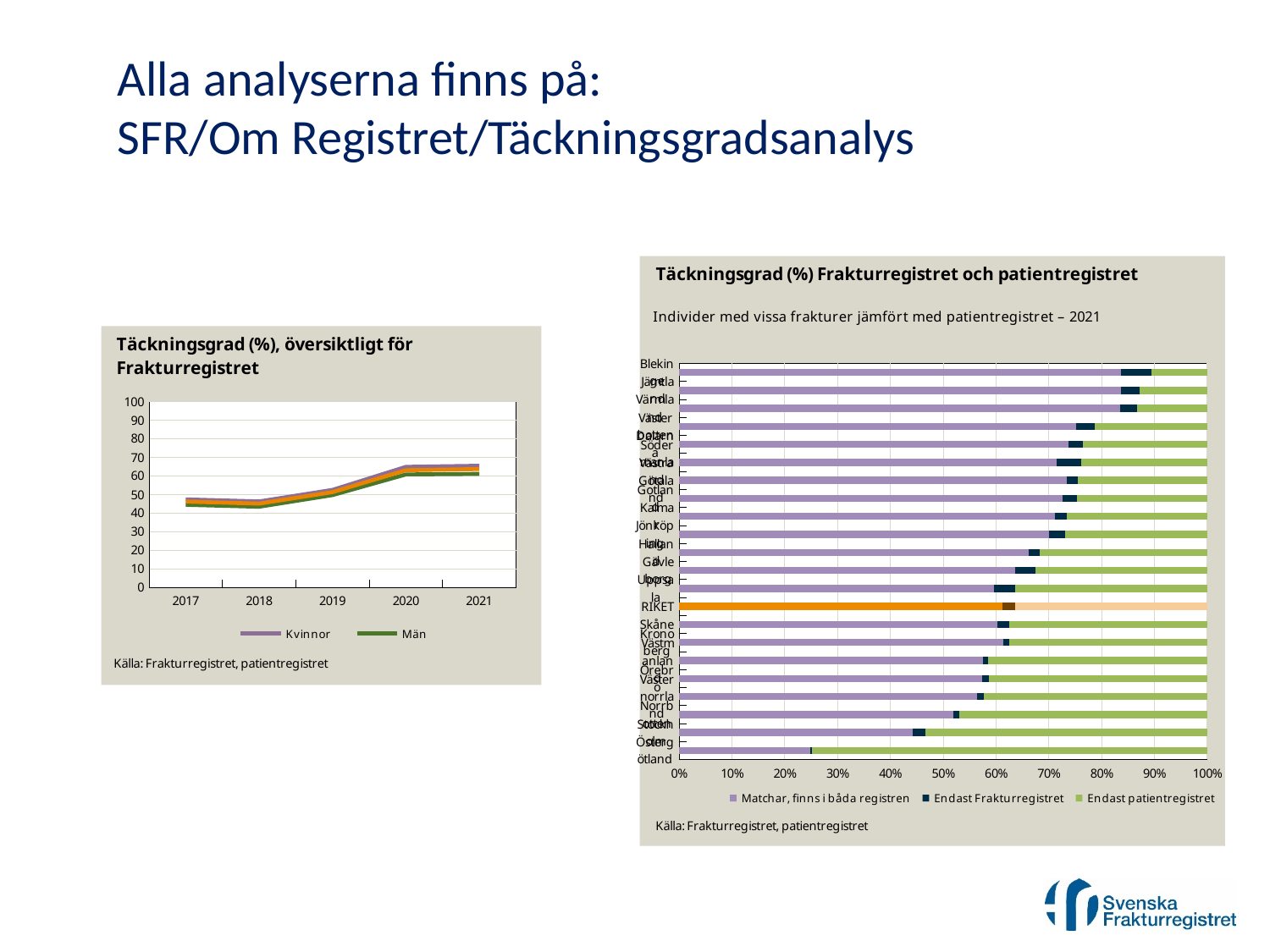
What kind of chart is the left chart titled 'Täckningsgrad (%), översiktligt för Frakturregistret'? Line chart In the left chart 'Täckningsgrad (%), översiktligt för Frakturregistret', is the value for Kvinnor in 2021 greater or less than 50? greater In the right chart 'Täckningsgrad (%) Frakturregistret och patientregistret', is the 'Matchar, finns i båda registren' value for RIKET greater or less than 50%? greater In the left chart 'Täckningsgrad (%), översiktligt för Frakturregistret', is the value for Män in 2018 greater or less than 50? less What kind of chart is the right chart titled 'Täckningsgrad (%) Frakturregistret och patientregistret'? Stacked bar chart Which two series are listed in the legend of the left chart 'Täckningsgrad (%), översiktligt för Frakturregistret'? Kvinnor and Män How many series does the legend of the right chart 'Täckningsgrad (%) Frakturregistret och patientregistret' list? 3 In the right chart 'Täckningsgrad (%) Frakturregistret och patientregistret', which has the larger 'Matchar, finns i båda registren' share, Blekinge or Östergötland? Blekinge How many series does the legend of the left chart 'Täckningsgrad (%), översiktligt för Frakturregistret' list? 2 How many years are shown on the x axis of the left chart 'Täckningsgrad (%), översiktligt för Frakturregistret'? 5 In the right chart 'Täckningsgrad (%) Frakturregistret och patientregistret', which category's bar is highlighted in orange? RIKET In the left chart 'Täckningsgrad (%), översiktligt för Frakturregistret', do the values rise or fall from 2018 to 2020? Rise